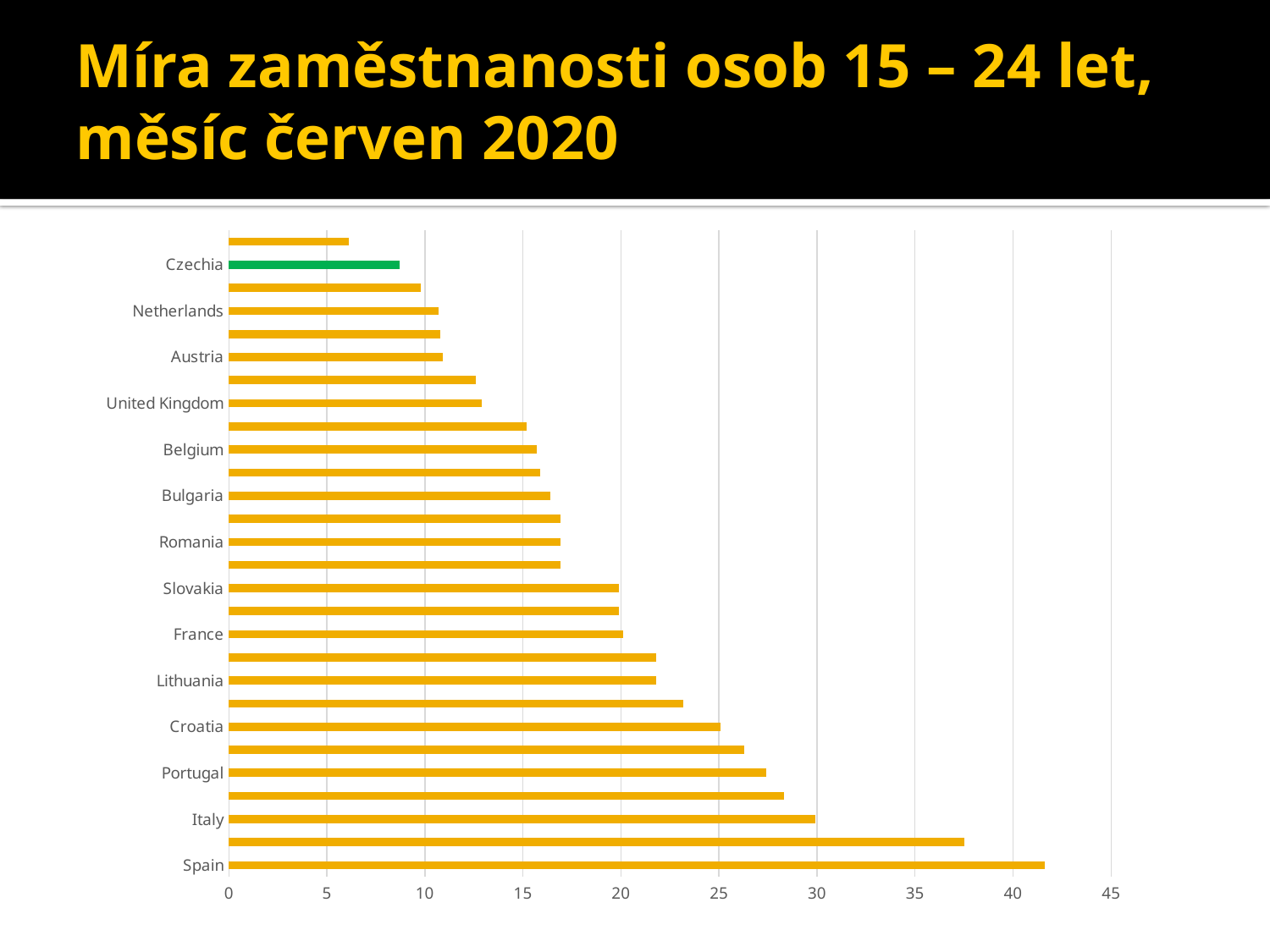
Is the value for Romania greater or less than 20? less Which country has the highest employment rate in the chart? Spain Which has the larger value, Italy or Spain? Spain Which has the larger value, Czechia or Portugal? Portugal Is the value for Portugal greater or less than 25? greater Which country's bar is shown in green rather than yellow? Czechia Is the value for Spain greater or less than 40? greater How many bars are plotted in the chart? 28 What kind of chart is shown on the slide? bar chart